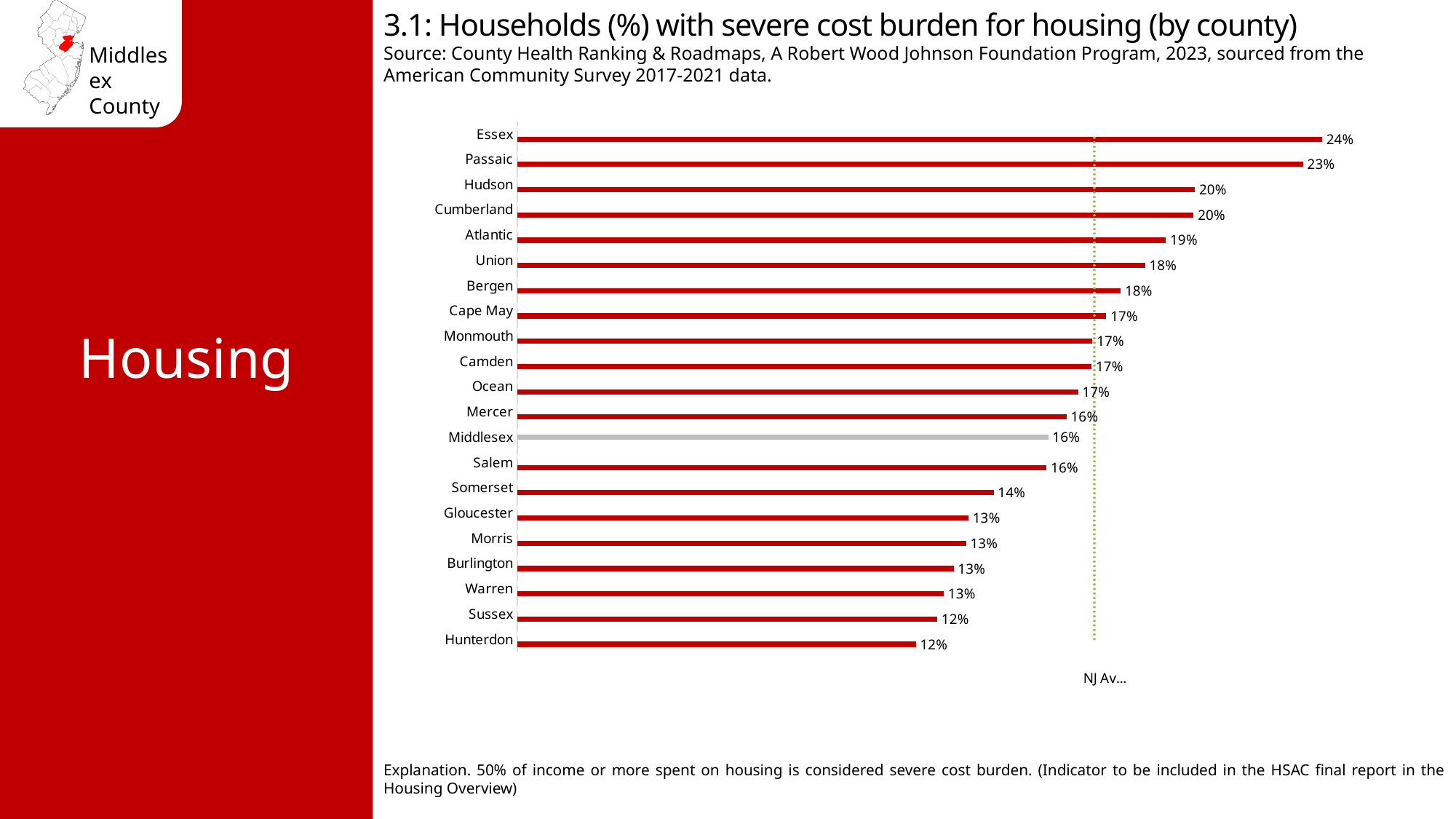
What is the value shown for Hunterdon County? 12% What is the difference in percentage points between Essex County and Middlesex County? 8 percentage points What is the value shown for Middlesex County? 16% What type of chart is used on this slide? Bar chart How many counties are shown in the chart? 21 What percentage of households in Essex County have a severe housing cost burden? 24% What does the vertical dotted line on the chart represent? NJ Average What is the value shown for Somerset County? 14% What is the value shown for Passaic County? 23% Which has a higher value, Atlantic County or Morris County? Atlantic Which county has the highest percentage of households with severe housing cost burden? Essex Which county's bar is shown in grey instead of red? Middlesex